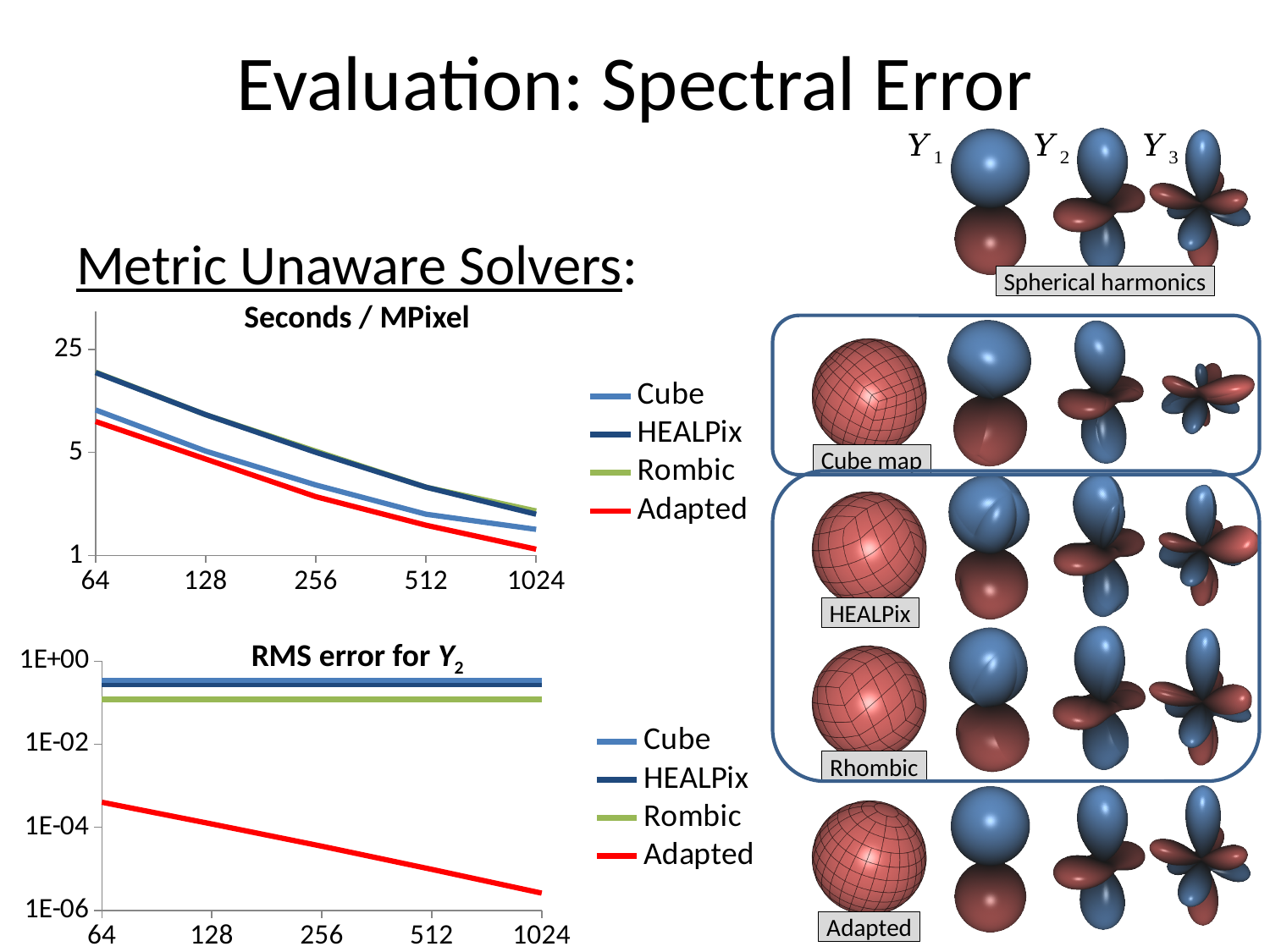
How many series does the legend of the "Seconds / MPixel" chart list? 4 In the "RMS error for Y2" chart, which is larger, the value for HEALPix or the value for Rombic? HEALPix In the "RMS error for Y2" chart, is the value for Adapted at 64 greater or less than 1E-02? less In the "RMS error for Y2" chart, does the Adapted series rise or fall as the x axis goes from 64 to 1024? fall In the "RMS error for Y2" chart, which series has the lowest error? Adapted In the "Seconds / MPixel" chart, is the value for HEALPix at 64 greater or less than 5? greater In the "Seconds / MPixel" chart, which series has the lowest value at 1024? Adapted How many x-axis values are shown on the "Seconds / MPixel" chart? 5 What kind of chart is the "Seconds / MPixel" chart? line chart In the "Seconds / MPixel" chart, is the value for Adapted at 1024 greater or less than 5? less In the "Seconds / MPixel" chart, do the values rise or fall as the x axis goes from 64 to 1024? fall